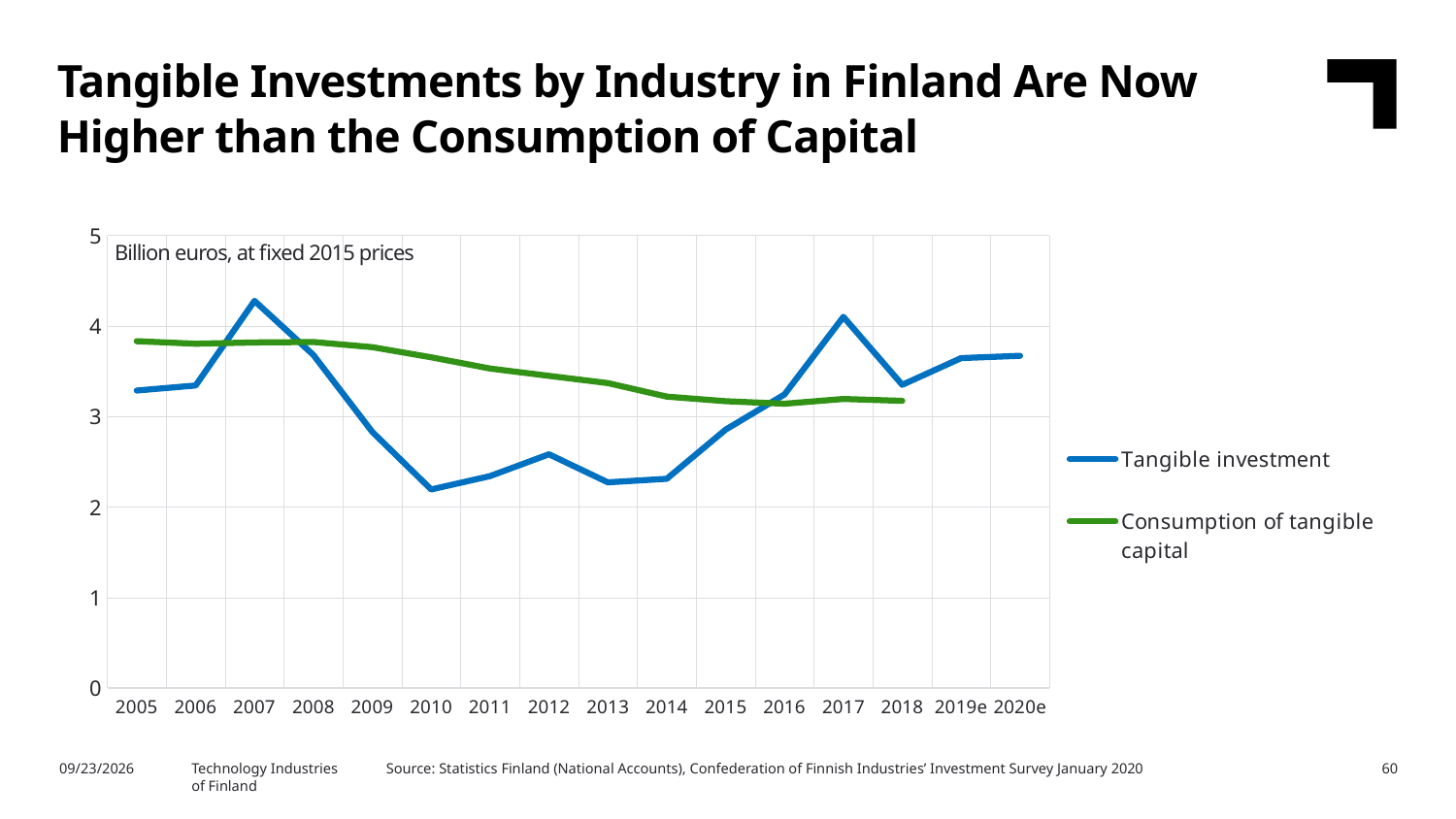
Is the value for Tangible investment in 2007 greater or less than 4? greater Is the value for Tangible investment in 2019e greater or less than 3? greater How many years are labelled along the x axis? 16 In 2010, which series has the larger value, Tangible investment or Consumption of tangible capital? Consumption of tangible capital How many series does the legend list? 2 What kind of chart is shown on the slide? Line chart Does the Tangible investment line rise or fall from 2014 to 2017? Rise Is the value for Consumption of tangible capital in 2005 greater or less than 3? greater Does the Consumption of tangible capital line rise or fall from 2005 to 2018? Fall In 2017, which series has the larger value, Tangible investment or Consumption of tangible capital? Tangible investment What unit is stated in the label inside the chart area? Billion euros, at fixed 2015 prices